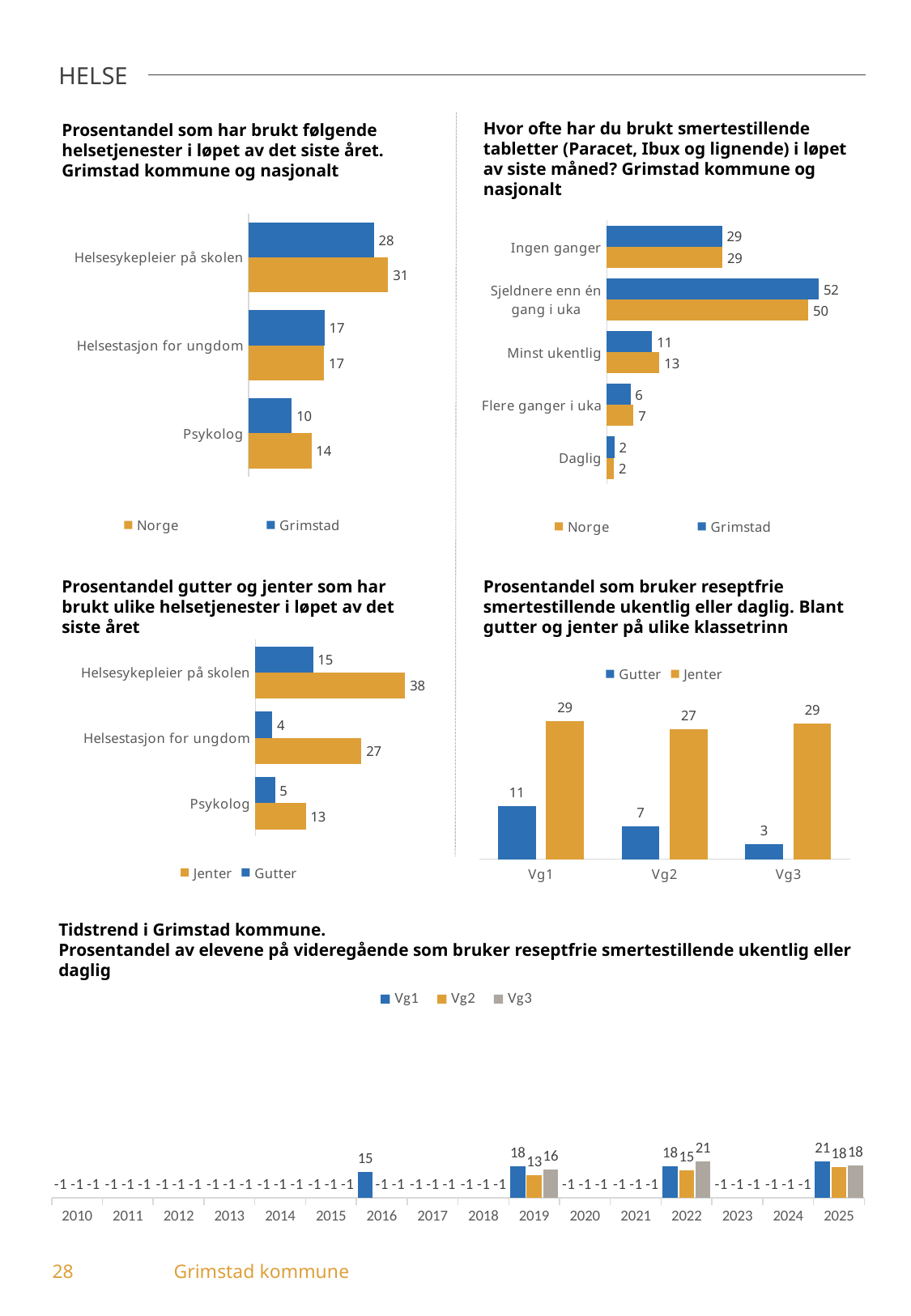
In the chart 'Prosentandel som bruker reseptfrie smertestillende ukentlig eller daglig', what is the value for Gutter in Vg3? 3 In the chart 'Hvor ofte har du brukt smertestillende tabletter', what is the Norge value for Minst ukentlig? 13 In the chart 'Prosentandel som bruker reseptfrie smertestillende ukentlig eller daglig', how many series does the legend list? 2 In the chart 'Prosentandel som har brukt følgende helsetjenester i løpet av det siste året', what is the difference between the Norge and Grimstad values for Psykolog? 4 What kind of chart is the 'Tidstrend i Grimstad kommune' chart at the bottom of the slide? Bar chart In the chart 'Tidstrend i Grimstad kommune', what is the value for Vg3 in 2022? 21 In the chart 'Prosentandel som har brukt følgende helsetjenester i løpet av det siste året', what is the value for Norge for Helsesykepleier på skolen? 31 In the chart 'Prosentandel gutter og jenter som har brukt ulike helsetjenester', which is larger for Helsesykepleier på skolen, Gutter or Jenter? Jenter In the chart 'Prosentandel gutter og jenter som har brukt ulike helsetjenester', what is the value for Jenter for Helsestasjon for ungdom? 27 In the chart 'Hvor ofte har du brukt smertestillende tabletter', which category has the highest value for Grimstad? Sjeldnere enn én gang i uka In the chart 'Hvor ofte har du brukt smertestillende tabletter', how many categories are shown? 5 In the chart 'Prosentandel som bruker reseptfrie smertestillende ukentlig eller daglig', what is the difference between Jenter and Gutter in Vg2? 20